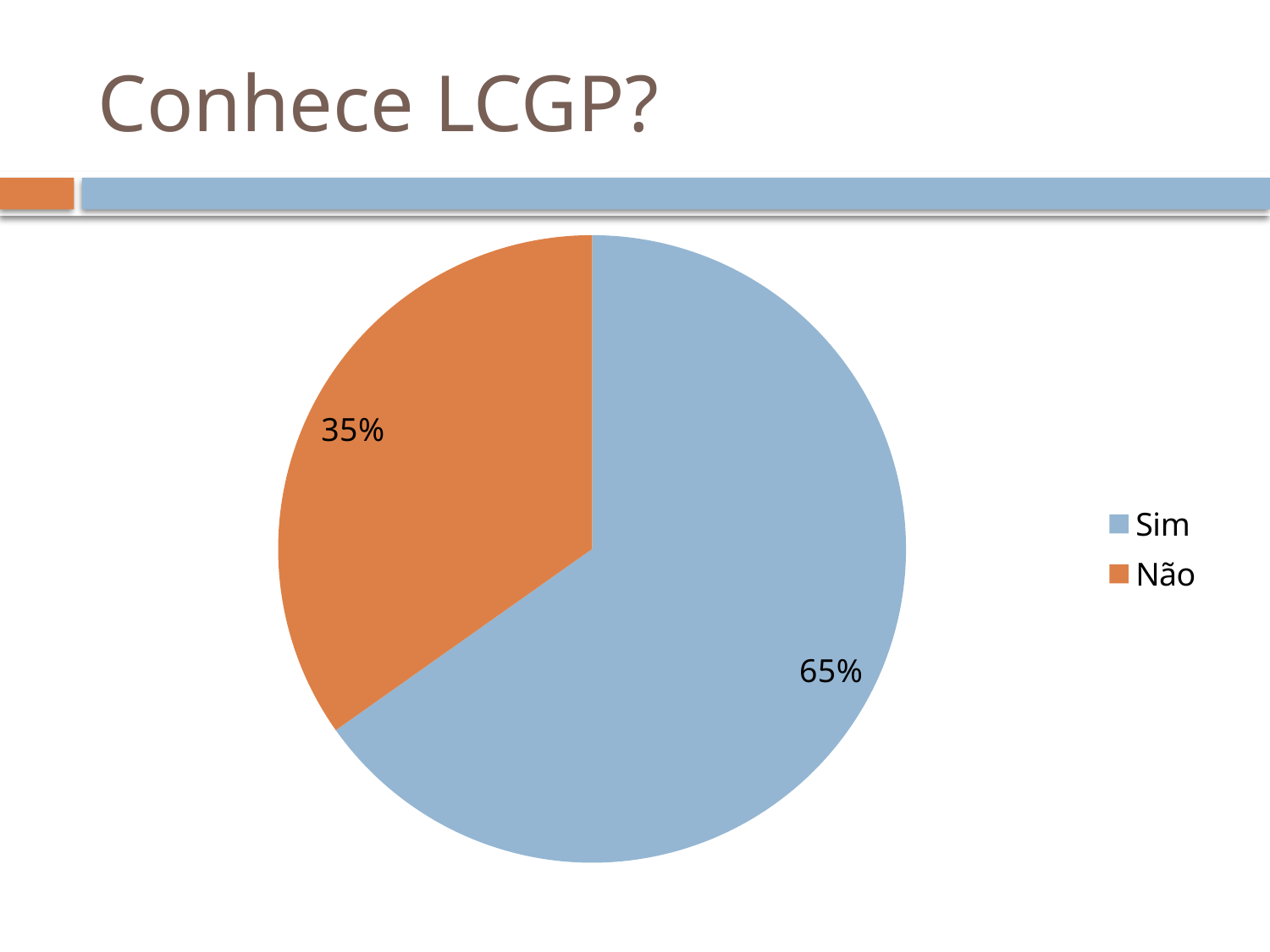
Which slice of the pie is the smallest? Não What is the title of the slide containing the chart? Conhece LCGP? How many entries does the legend list? 2 What colour is the "Não" slice in the pie chart? Orange Which slice of the pie is the largest? Sim What percentage of the pie is labelled "Não"? 35% What is the difference in percentage points between the "Sim" and "Não" slices? 30 Which is larger, the "Sim" slice or the "Não" slice? Sim What percentage of the pie is labelled "Sim"? 65% How many slices does the pie chart have? 2 What share of the pie does the "Não" slice represent? 35% What kind of chart is shown on the slide? Pie chart